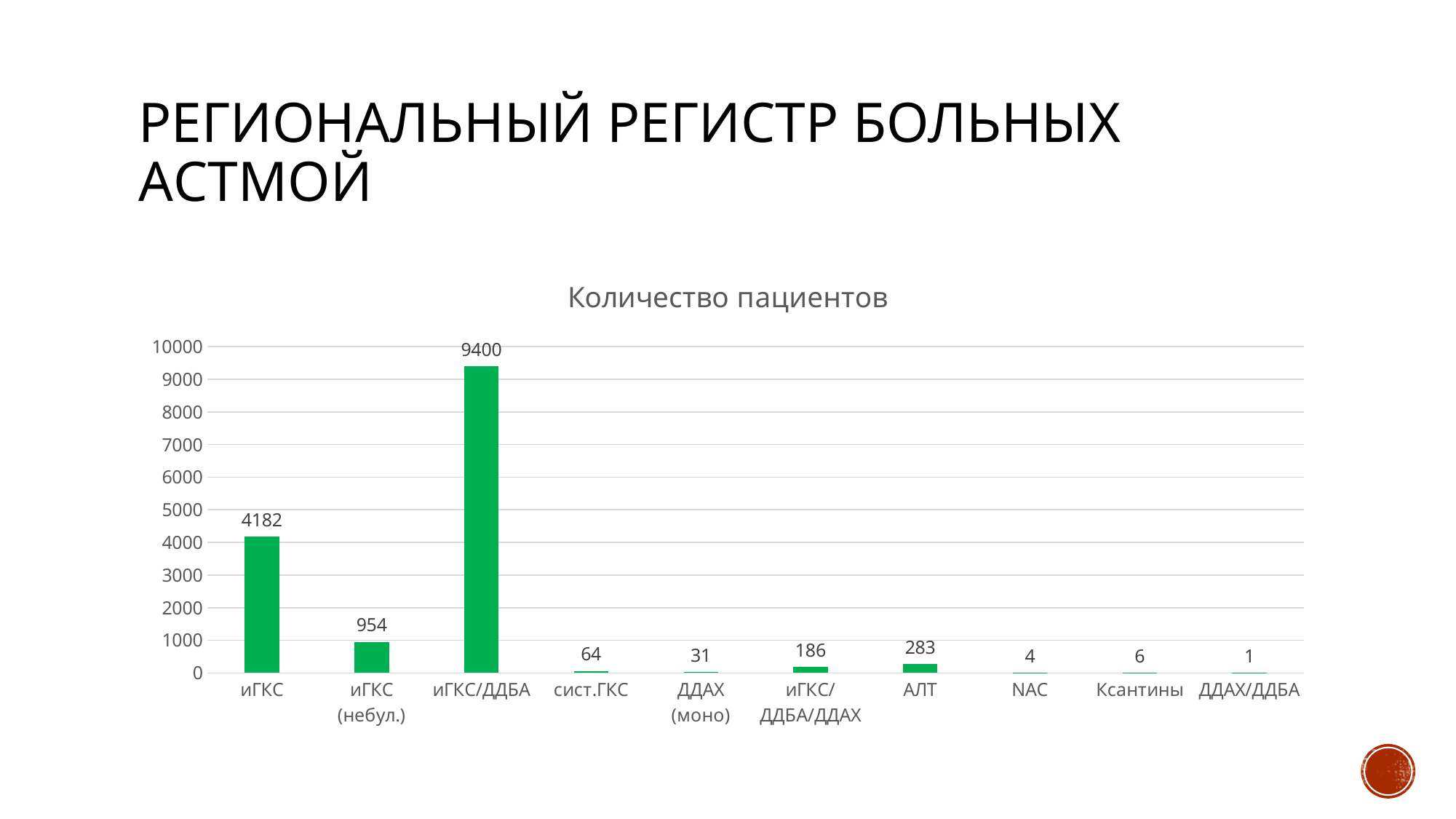
What is the value for иГКС (небул.)? 954 Which category has the lowest value? ДДАХ/ДДБА What is the value for ДДАХ (моно)? 31 How many categories are shown on the x axis? 10 What is the value for иГКС/ДДБА? 9400 What is the difference between the values for иГКС/ДДБА and иГКС? 5218 What is the title of the chart? Количество пациентов Which is larger, the value for АЛТ or the value for иГКС/ДДБА/ДДАХ? АЛТ Which category has the highest value? иГКС/ДДБА What kind of chart is shown? bar chart Is the value for иГКС greater or less than 4000? greater What is the value for АЛТ? 283